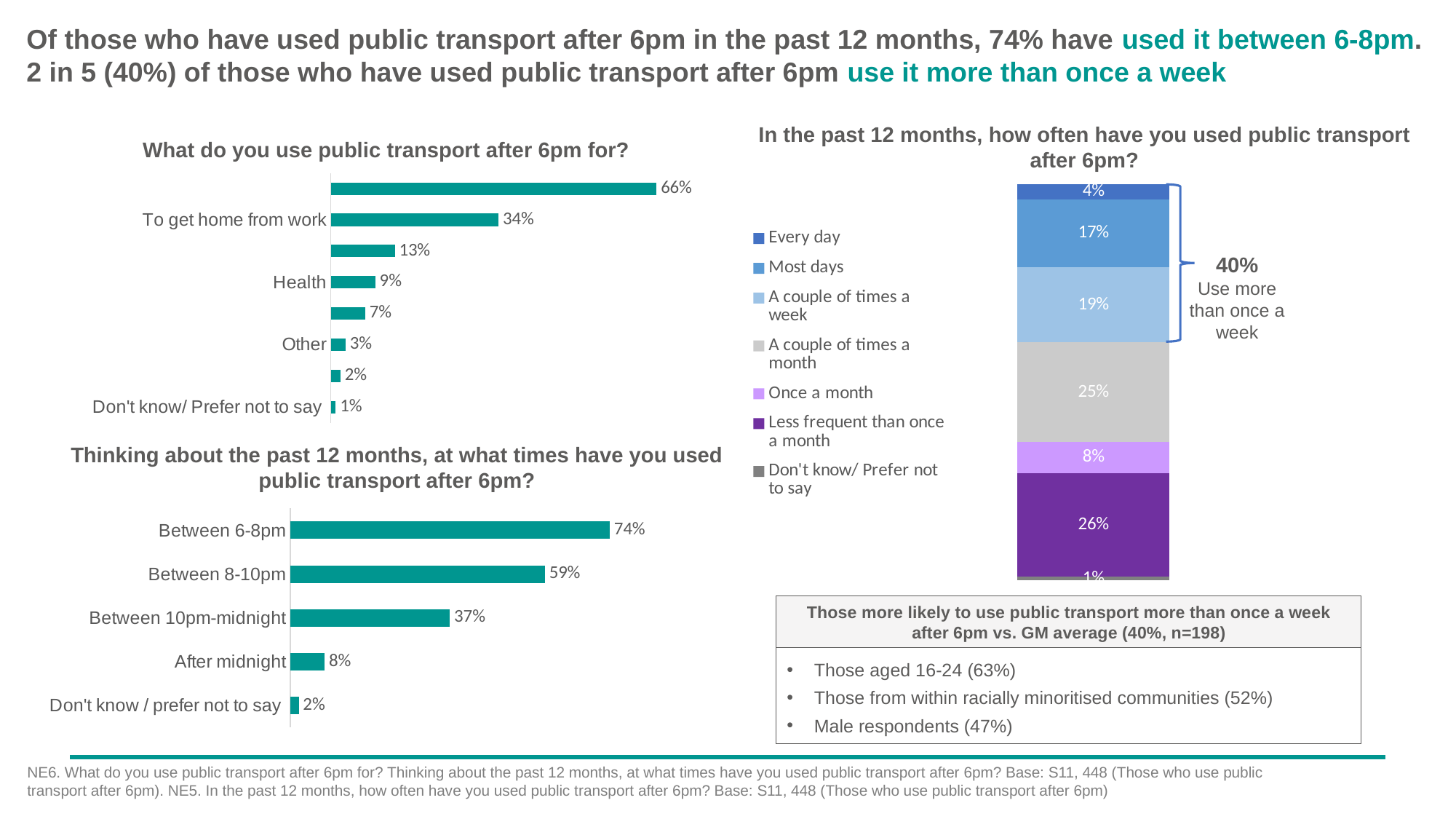
In the chart 'In the past 12 months, how often have you used public transport after 6pm?', how many series does the legend list? 7 In the chart 'Thinking about the past 12 months, at what times have you used public transport after 6pm?', which category has the highest value? Between 6-8pm In the chart 'In the past 12 months, how often have you used public transport after 6pm?', what is the difference between Less frequent than once a month and Once a month? 18% In the chart 'Thinking about the past 12 months, at what times have you used public transport after 6pm?', what is the difference between Between 6-8pm and Between 10pm-midnight? 37% In the chart 'Thinking about the past 12 months, at what times have you used public transport after 6pm?', how many categories are shown? 5 What kind of chart is 'What do you use public transport after 6pm for?' Bar chart In the chart 'What do you use public transport after 6pm for?', what is the value for To get home from work? 34% In the chart 'Thinking about the past 12 months, at what times have you used public transport after 6pm?', which category has the lowest value? Don't know / prefer not to say In the chart 'In the past 12 months, how often have you used public transport after 6pm?', what is the value for A couple of times a month? 25% In the chart 'What do you use public transport after 6pm for?', what is the value for Health? 9% In the chart 'What do you use public transport after 6pm for?', which is larger, Health or Other? Health In the chart 'Thinking about the past 12 months, at what times have you used public transport after 6pm?', what is the value for Between 8-10pm? 59%